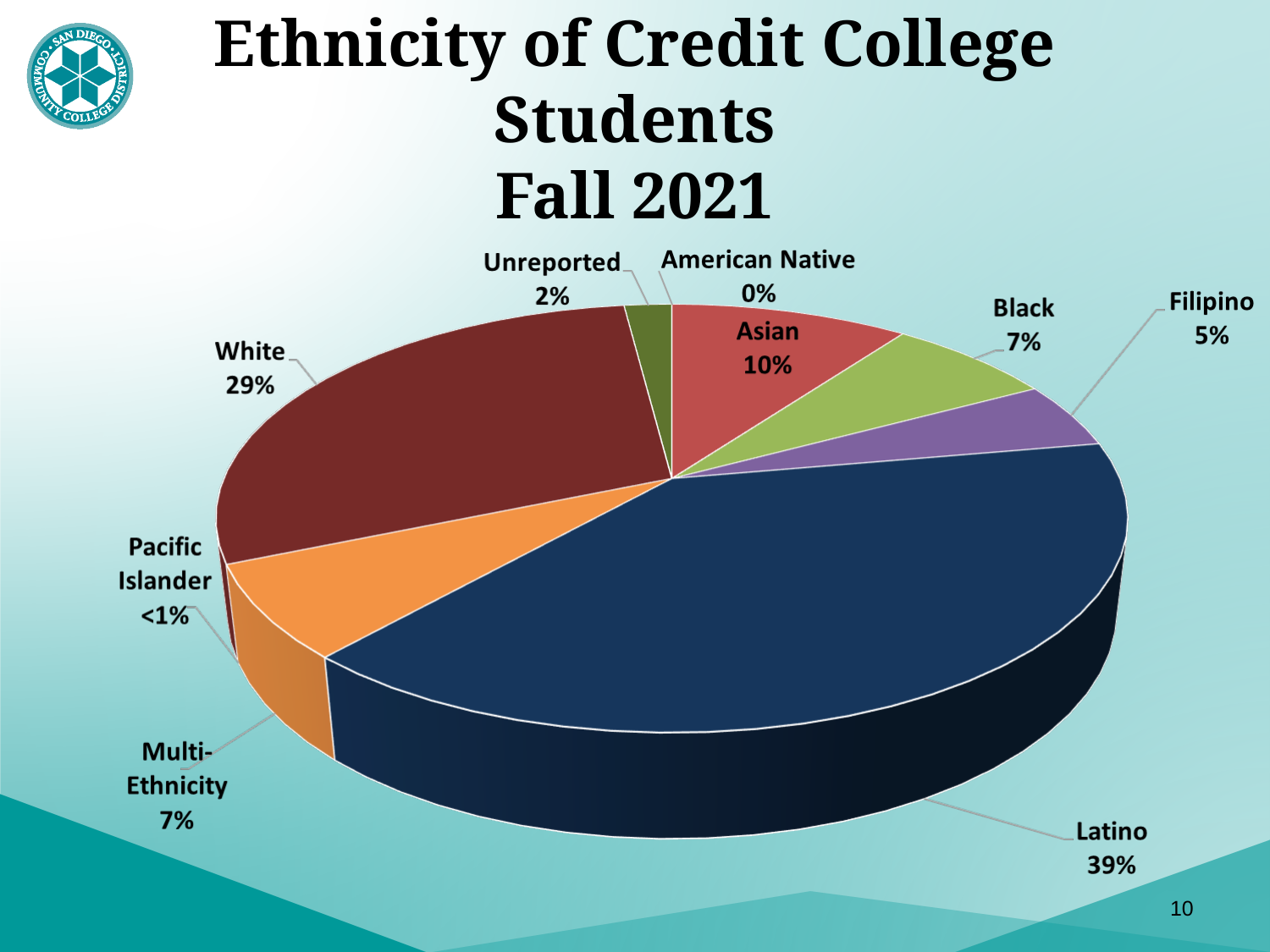
Which is larger, the share for Asian or the share for Filipino? Asian How many percentage points larger is the Latino share than the White share? 10 percentage points Which ethnicity has the largest share of the pie? Latino What percentage of students are White? 29% What is the title of the chart? Ethnicity of Credit College Students Fall 2021 What kind of chart is shown on the slide? Pie chart What percentage is shown for Pacific Islander students? <1% What is the value shown for Asian students? 10% What share of credit college students are Latino? 39% How many ethnicity categories are shown in the pie chart? 9 What share of students is Unreported? 2% Which labelled ethnicity has the smallest share shown? American Native